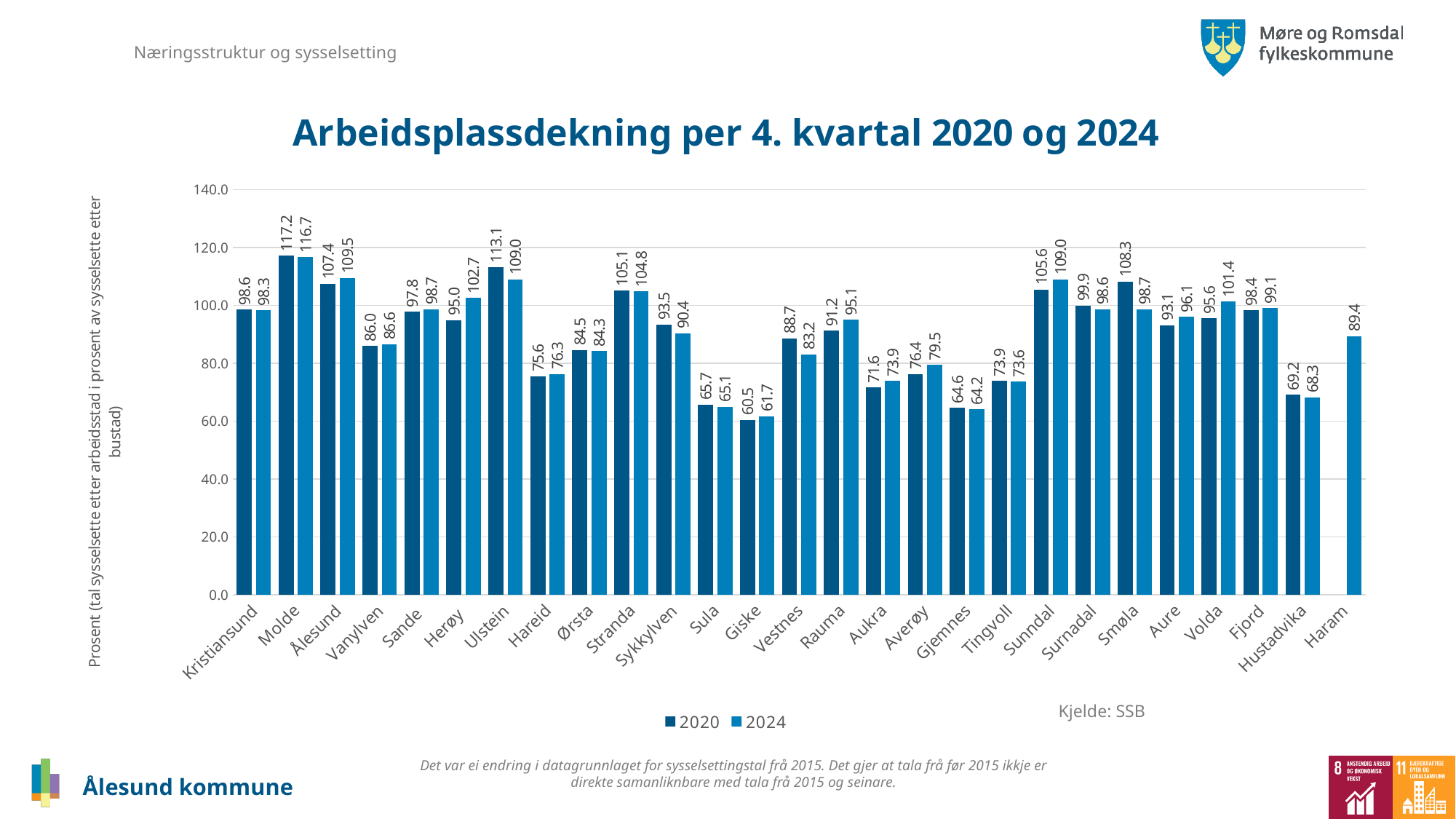
How many municipalities are shown on the x axis? 27 How many series does the legend list? 2 What is the 2024 value for Herøy? 102.7 Which municipality has the lowest 2020 value? Giske What is the difference between the 2020 and 2024 values for Smøla? 9.6 Which is larger for Ulstein: the 2020 value or the 2024 value? 2020 What is the difference between the 2024 and 2020 values for Herøy? 7.7 Which municipality has the highest 2024 value? Molde Is the 2024 value for Sunndal greater or less than 100.0? greater What is the 2024 value for Haram? 89.4 What is the 2020 value for Molde? 117.2 What kind of chart is shown on the slide? Bar chart